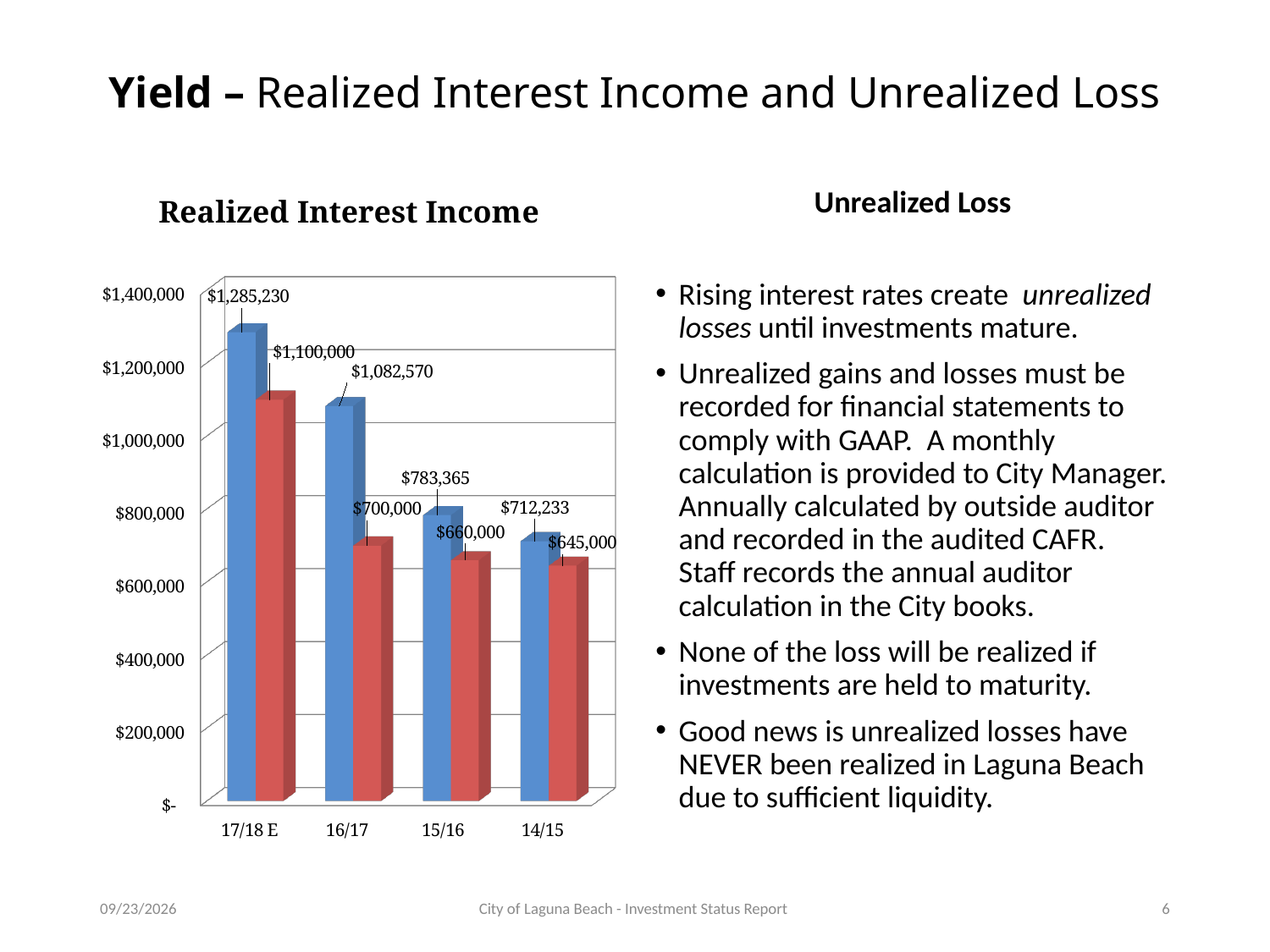
In the Realized Interest Income chart, what is the difference between the blue bar and the red bar for 16/17? $382,570 How many categories are shown on the x axis of the Realized Interest Income chart? 4 In the Realized Interest Income chart, what is the value of the blue bar for 15/16? $783,365 In the Realized Interest Income chart, what is the value of the red bar for 14/15? $645,000 In the Realized Interest Income chart, what is the value of the red bar for 16/17? $700,000 In the Realized Interest Income chart, which category has the highest blue bar? 17/18 E In the Realized Interest Income chart, do the blue bars rise or fall from left to right across the x axis? Fall What kind of chart is the Realized Interest Income chart? Bar chart In the Realized Interest Income chart, what is the value of the blue bar for 17/18 E? $1,285,230 In the Realized Interest Income chart, what is the difference between the blue bar and the red bar for 17/18 E? $185,230 In the Realized Interest Income chart, which category has the lowest red bar? 14/15 In the Realized Interest Income chart, which is larger: the blue bar for 16/17 or the red bar for 17/18 E? The red bar for 17/18 E